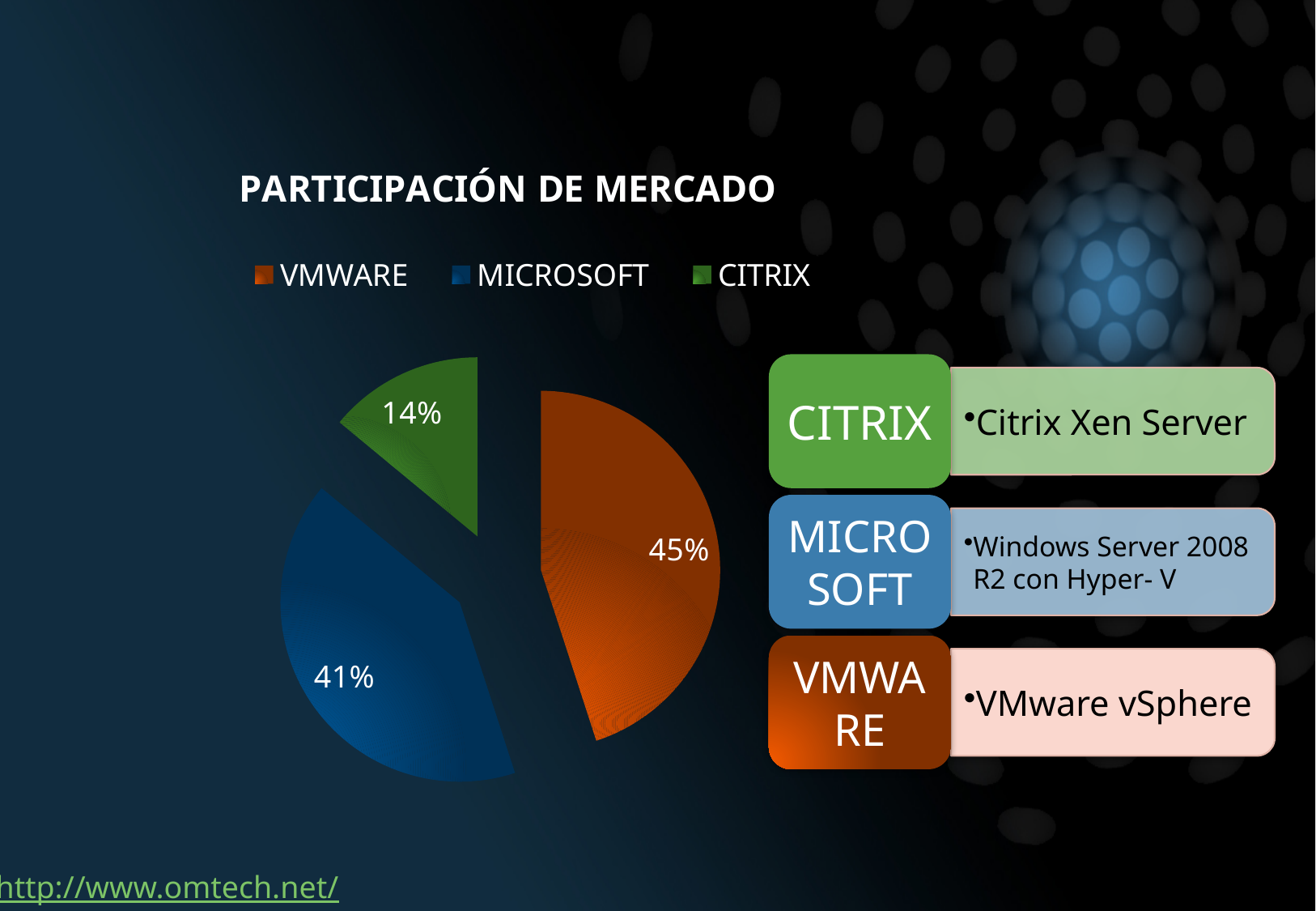
Which is larger, the MICROSOFT slice or the CITRIX slice? MICROSOFT What share of the pie does VMWARE hold? 45% What is the title of the chart? PARTICIPACIÓN DE MERCADO What is the difference between the VMWARE and MICROSOFT shares? 4% How many slices does the pie chart have? 3 What share of the pie does MICROSOFT hold? 41% Which colour represents CITRIX in the legend? Green What is the difference between the MICROSOFT and CITRIX shares? 27% Which category has the largest slice of the pie? VMWARE What share of the pie does CITRIX hold? 14% Which category has the smallest slice of the pie? CITRIX What type of chart is shown on the slide? Pie chart